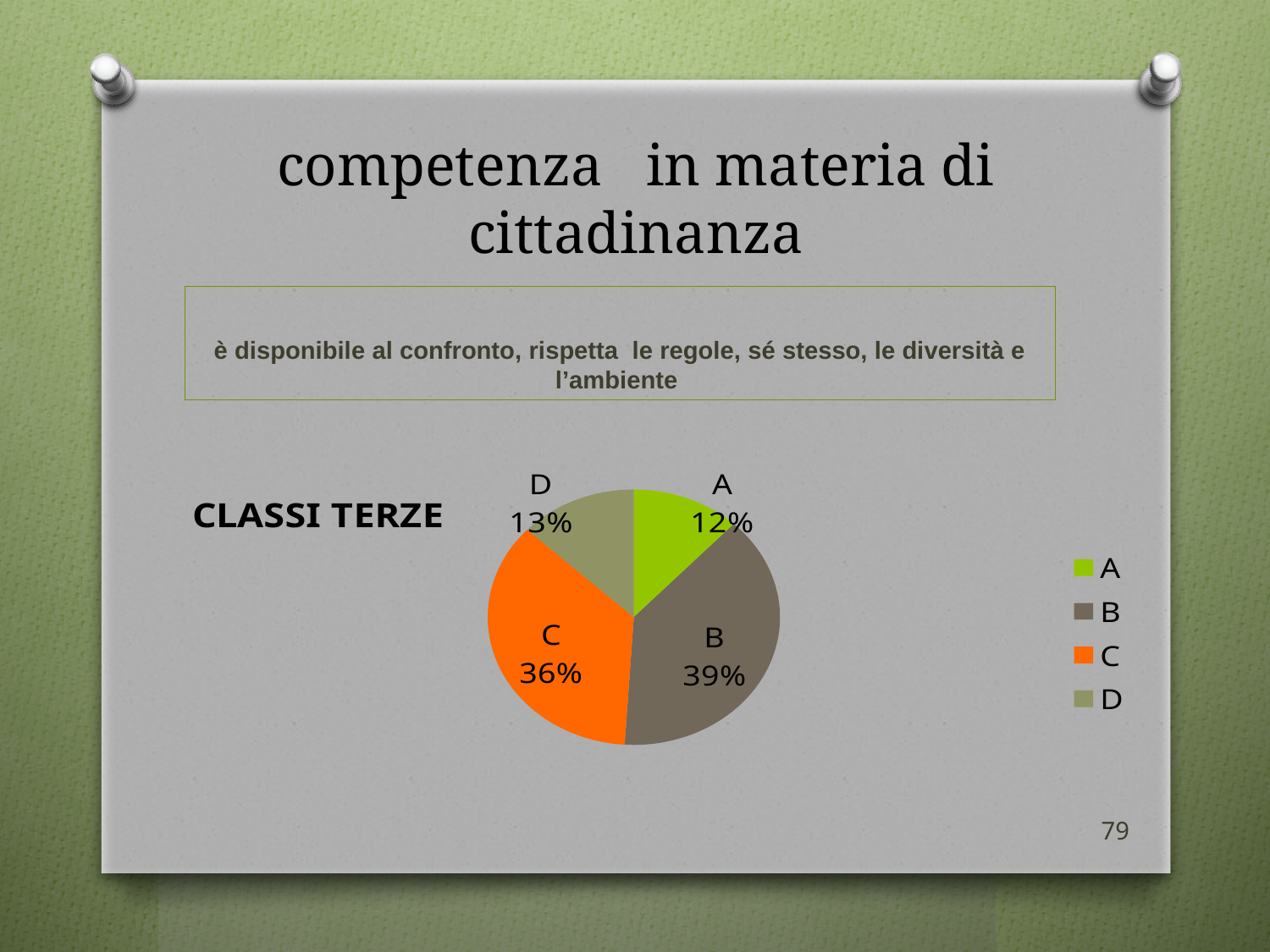
How many slices does the pie chart have? 4 Which is larger, the share for C or the share for D? C What is the difference in percentage points between slice B and slice C? 3 What percentage does slice C represent in the pie chart? 36% What colour is the slice for category C in the pie chart? orange Which category has the largest share of the pie chart? B Which category has the smallest share of the pie chart? A How many entries does the legend list? 4 What percentage does slice B represent in the pie chart? 39% What percentage does slice D represent in the pie chart? 13% What type of chart is shown on the slide? pie chart What percentage does slice A represent in the pie chart? 12%